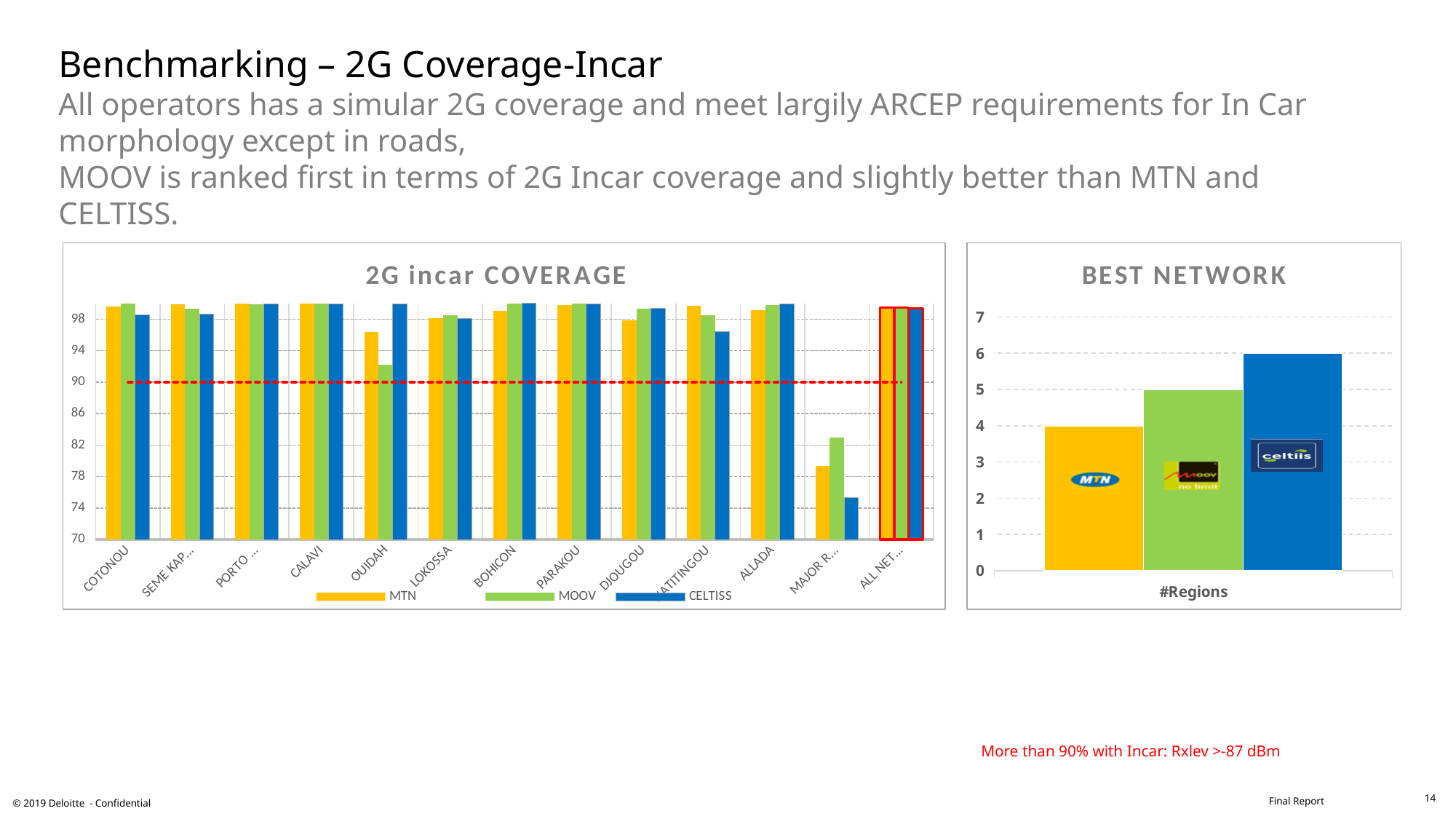
In the "2G incar COVERAGE" chart, at what value is the red dashed horizontal line drawn? 90 How many categories are shown on the x axis of the "2G incar COVERAGE" chart? 13 In the "2G incar COVERAGE" chart, is the CELTISS value for OUIDAH greater or less than 98? greater In the "2G incar COVERAGE" chart, which operator has the lowest value for the MAJOR R... category? CELTISS How many series does the legend of the "2G incar COVERAGE" chart list? 3 In the "2G incar COVERAGE" chart, which is larger for OUIDAH: the MTN value or the MOOV value? MTN In the "BEST NETWORK" chart, is the value for MOOV greater or less than 4? greater In the "2G incar COVERAGE" chart, is the MTN value for MAJOR R... greater or less than 82? less In the "BEST NETWORK" chart, which operator has the highest number of regions? CELTIIS What kind of chart is the "2G incar COVERAGE" chart? combination bar and line chart (bars with a dashed target line) In the "BEST NETWORK" chart, which operator has the lowest number of regions? MTN